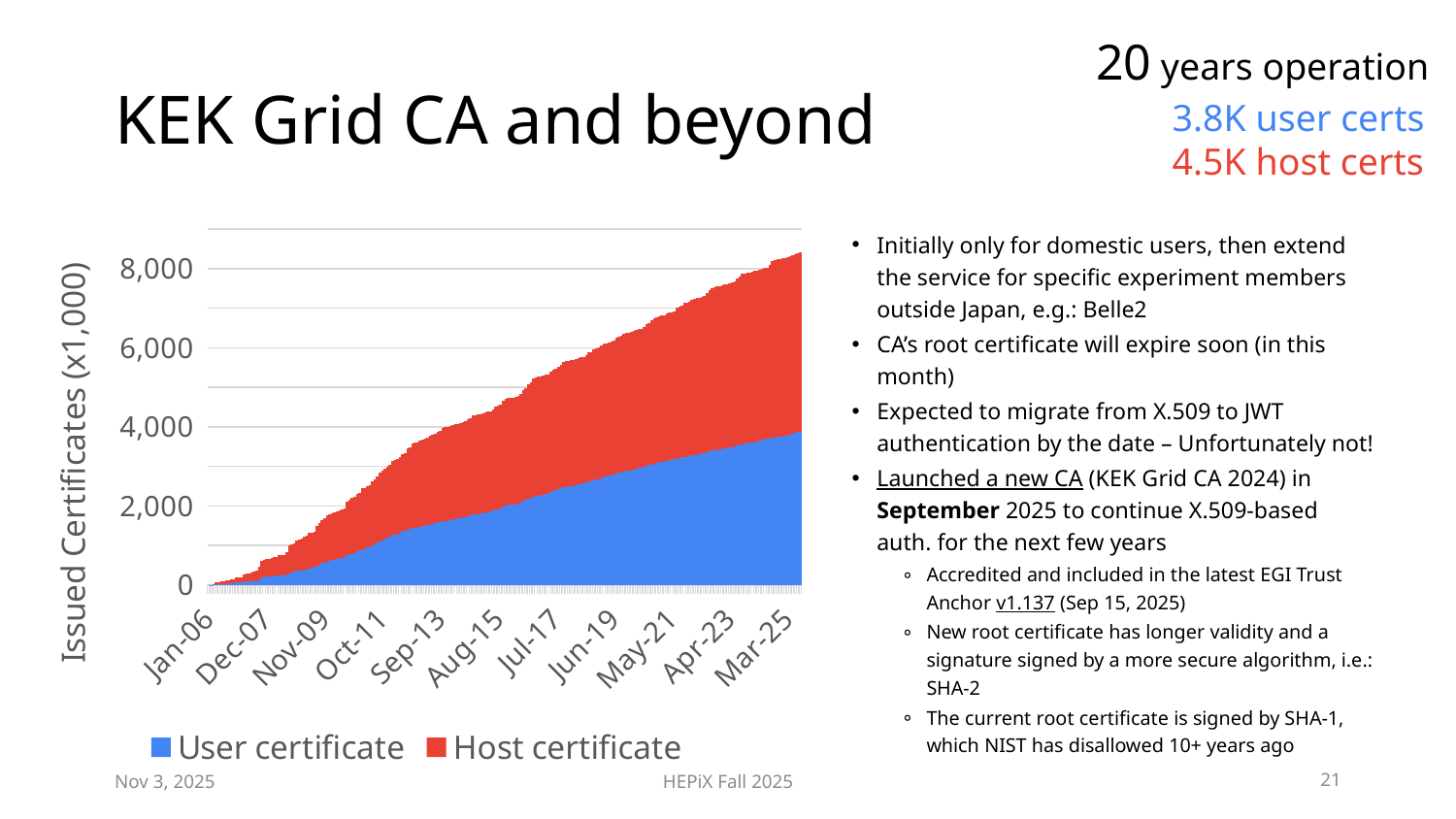
Is the total of issued certificates at Mar-25 greater or less than 8,000? greater What are the two series named in the chart legend? User certificate and Host certificate How many series does the chart legend list? 2 Is the value for User certificate at Mar-25 greater or less than 4,000? less Do the total issued certificates rise or fall from Jan-06 to Mar-25? Rise What is the title of the chart's vertical axis? Issued Certificates (x1,000) Is the total of issued certificates at Oct-11 greater or less than 2,000? greater How many date labels are shown along the x axis of the chart? 11 At Mar-25, which series contributes more to the total: User certificate or Host certificate? Host certificate What kind of chart is shown on the slide? Stacked bar chart